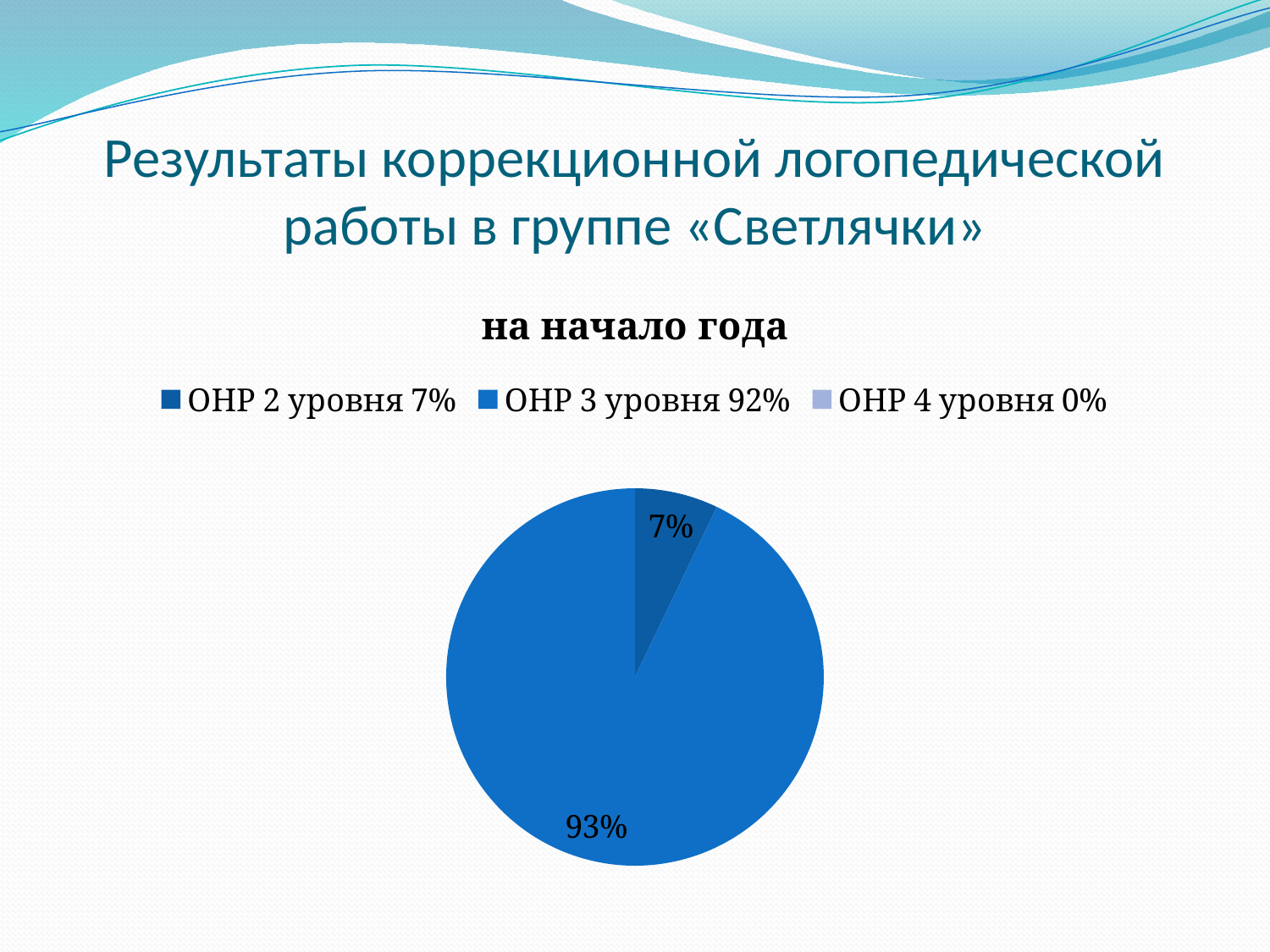
What kind of chart is shown on the slide? pie chart Which category has the smallest share according to the legend? ОНР 4 уровня Which is larger, the slice for ОНР 2 уровня or the slice for ОНР 3 уровня? ОНР 3 уровня What percentage does the legend give for ОНР 3 уровня? 92% How many entries does the chart legend list? 3 What is the difference between the two data labels printed on the pie slices? 86% What is the title of the chart? на начало года Which category has the largest slice of the pie? ОНР 3 уровня What data label is printed on the ОНР 2 уровня slice of the pie? 7% What percentage does the legend give for ОНР 4 уровня? 0% What data label is printed on the largest slice of the pie? 93% How many slices are visibly drawn in the pie? 2